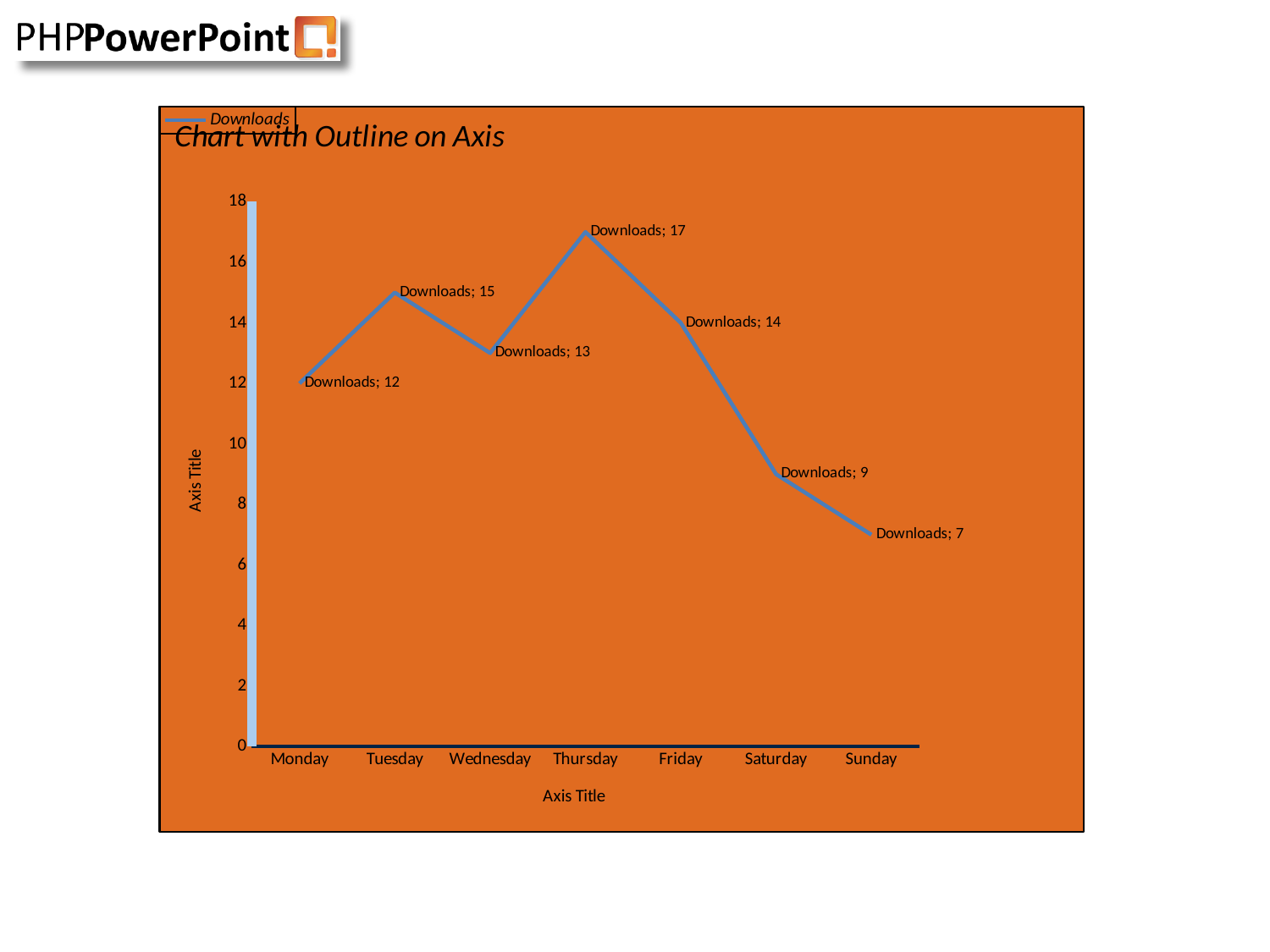
Which has a larger Downloads value, Tuesday or Wednesday? Tuesday Is the Downloads value for Saturday greater or less than 10? less What kind of chart is shown on the slide? line chart What is the title of the chart? Chart with Outline on Axis What is the value of Downloads for Monday? 12 Which day has the lowest Downloads value? Sunday How many series does the legend list? 1 How many days are plotted on the x axis? 7 Which day has the highest Downloads value? Thursday What is the difference between the Downloads values for Thursday and Friday? 3 What is the value of Downloads for Sunday? 7 What is the value of Downloads for Thursday? 17